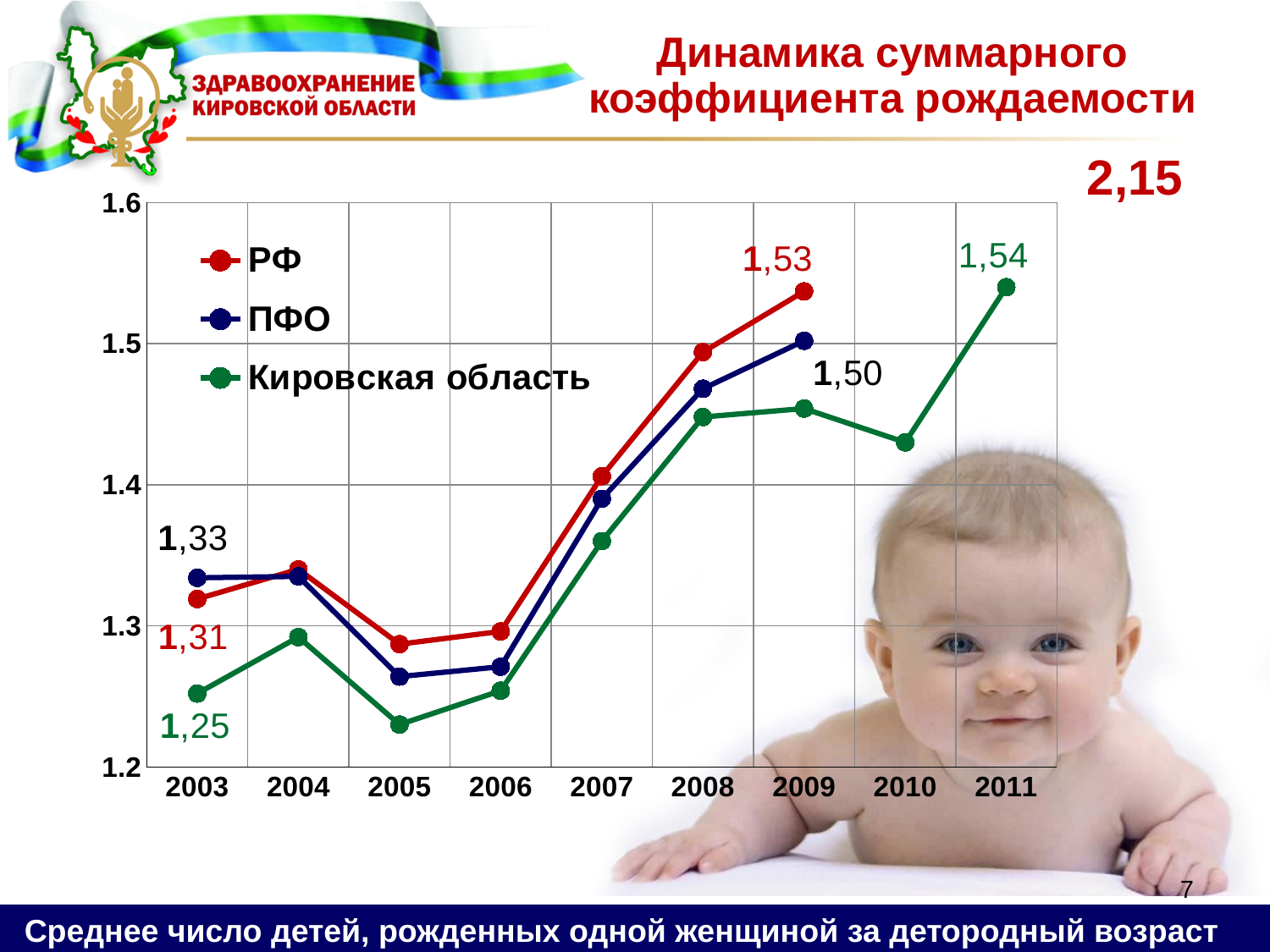
Which series had the lowest value in 2003? Кировская область Does the value for Кировская область rise or fall from 2006 to 2009? rise How many years are shown on the x axis? 9 What kind of chart is shown on the slide? line chart What is the value for РФ in 2003? 1,31 By how much did the value for РФ increase from 2003 to 2009? 0,22 How many series does the legend list? 3 Is the value for Кировская область in 2005 greater or less than 1.3? less What is the value for ПФО in 2009? 1,50 What is the value for Кировская область in 2011? 1,54 By how much did the value for Кировская область increase from 2003 to 2011? 0,29 What is the value for ПФО in 2003? 1,33